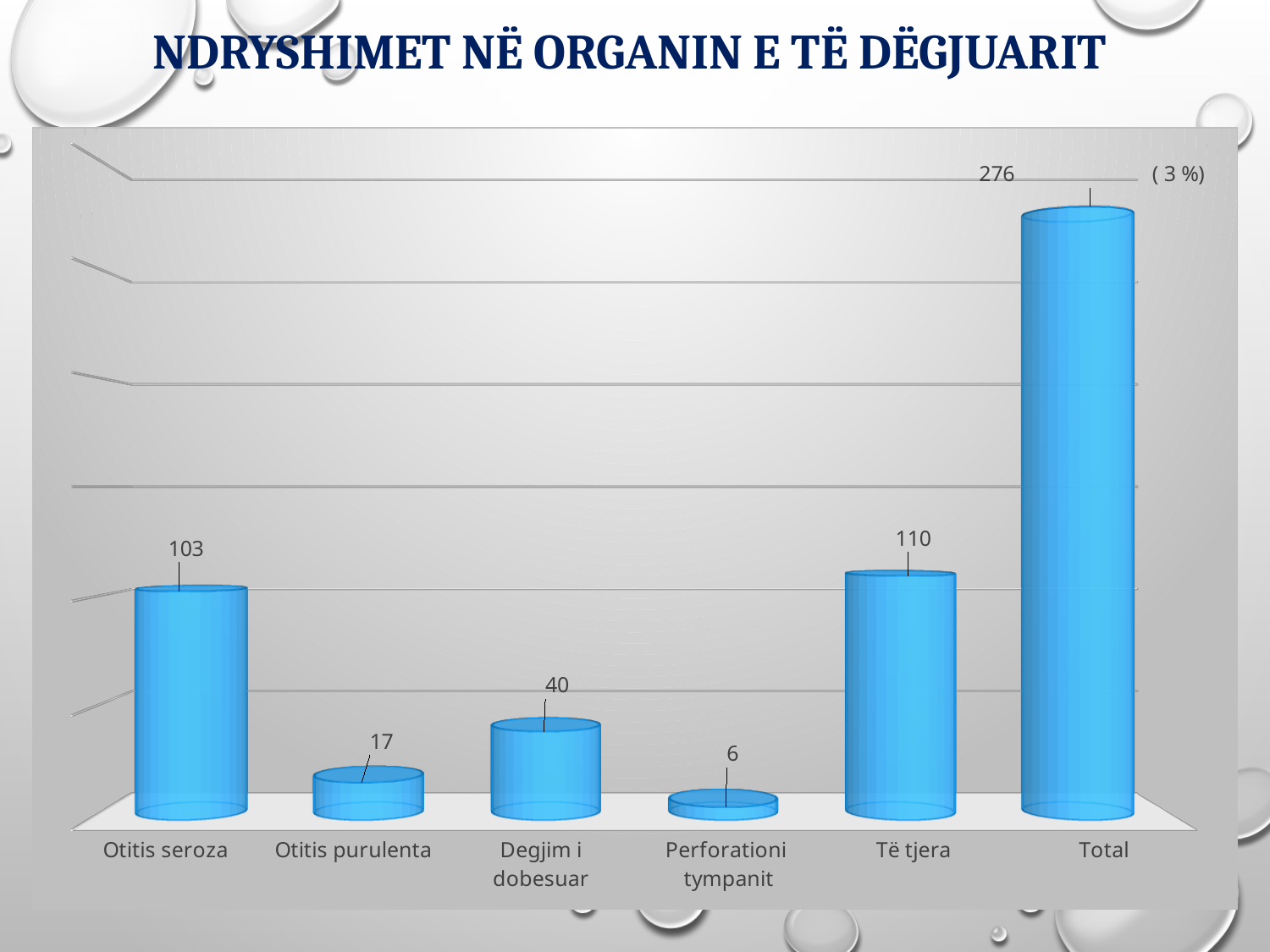
Excluding Total, which category has the highest value? Të tjera How many categories are shown on the x axis? 6 What is the value for Otitis purulenta? 17 What is the difference between the values for Të tjera and Otitis seroza? 7 What is the value for Total? 276 What is the value for Otitis seroza? 103 Which is larger, the value for Degjim i dobesuar or the value for Otitis purulenta? Degjim i dobesuar What is the value for Perforationi tympanit? 6 What is the value for Të tjera? 110 What kind of chart is shown on the slide? bar chart Which category has the lowest value? Perforationi tympanit What is the value for Degjim i dobesuar? 40